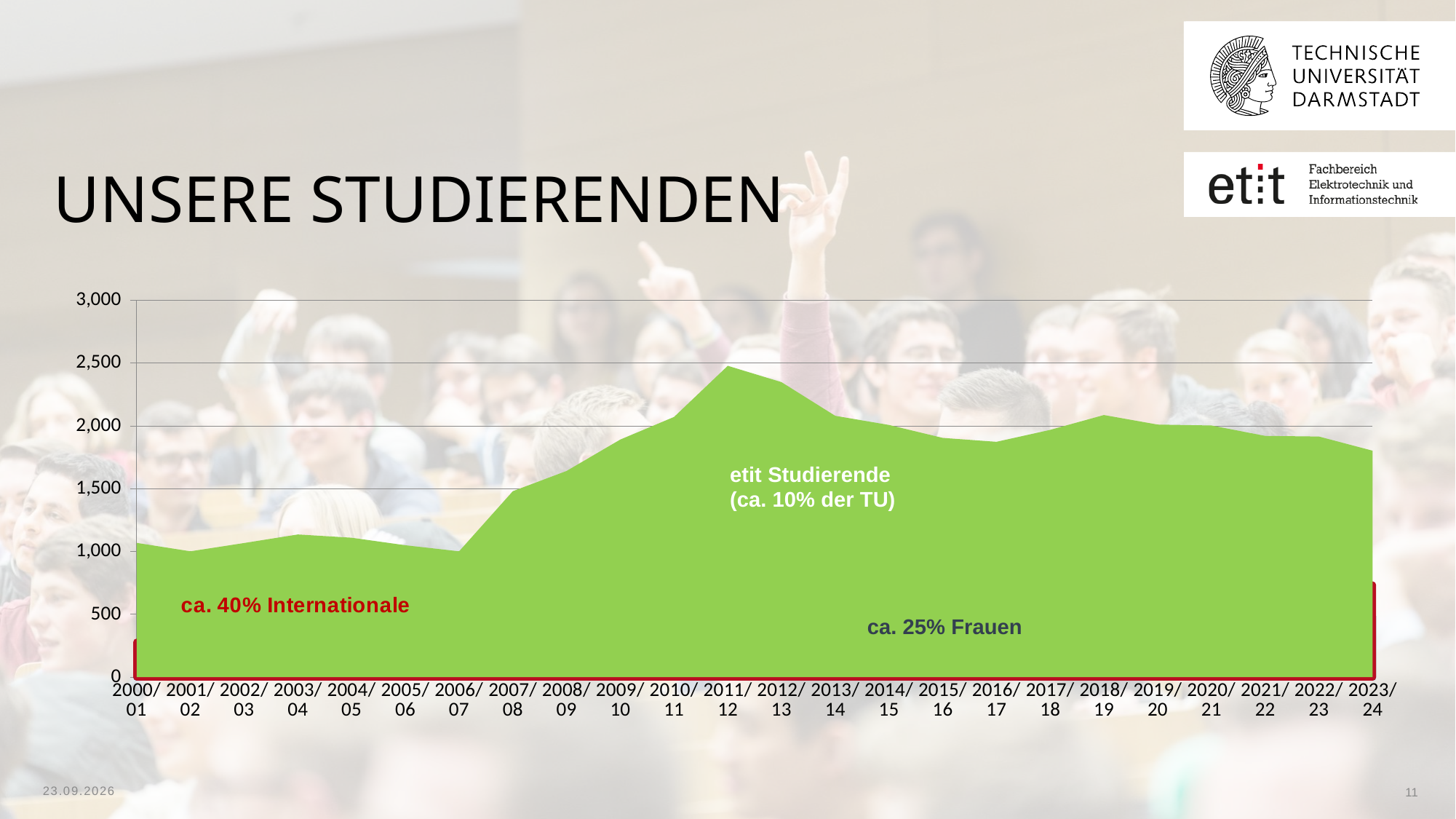
According to the annotation on the chart, what share of the etit students are women (Frauen)? ca. 25% Is the value for 2003/04 greater or less than 1,000? greater Is the value for 2011/12 greater or less than 2,000? greater According to the annotation on the chart, what share of the TU do the etit students make up? ca. 10% What kind of chart is shown on the slide? area chart Is the value for 2023/24 greater or less than 2,000? less Do the values rise or fall between 2006/07 and 2011/12? rise How many academic years are shown on the x axis of the chart? 24 In which academic year does the number of etit students reach its highest value? 2011/12 Which year has the larger value, 2011/12 or 2000/01? 2011/12